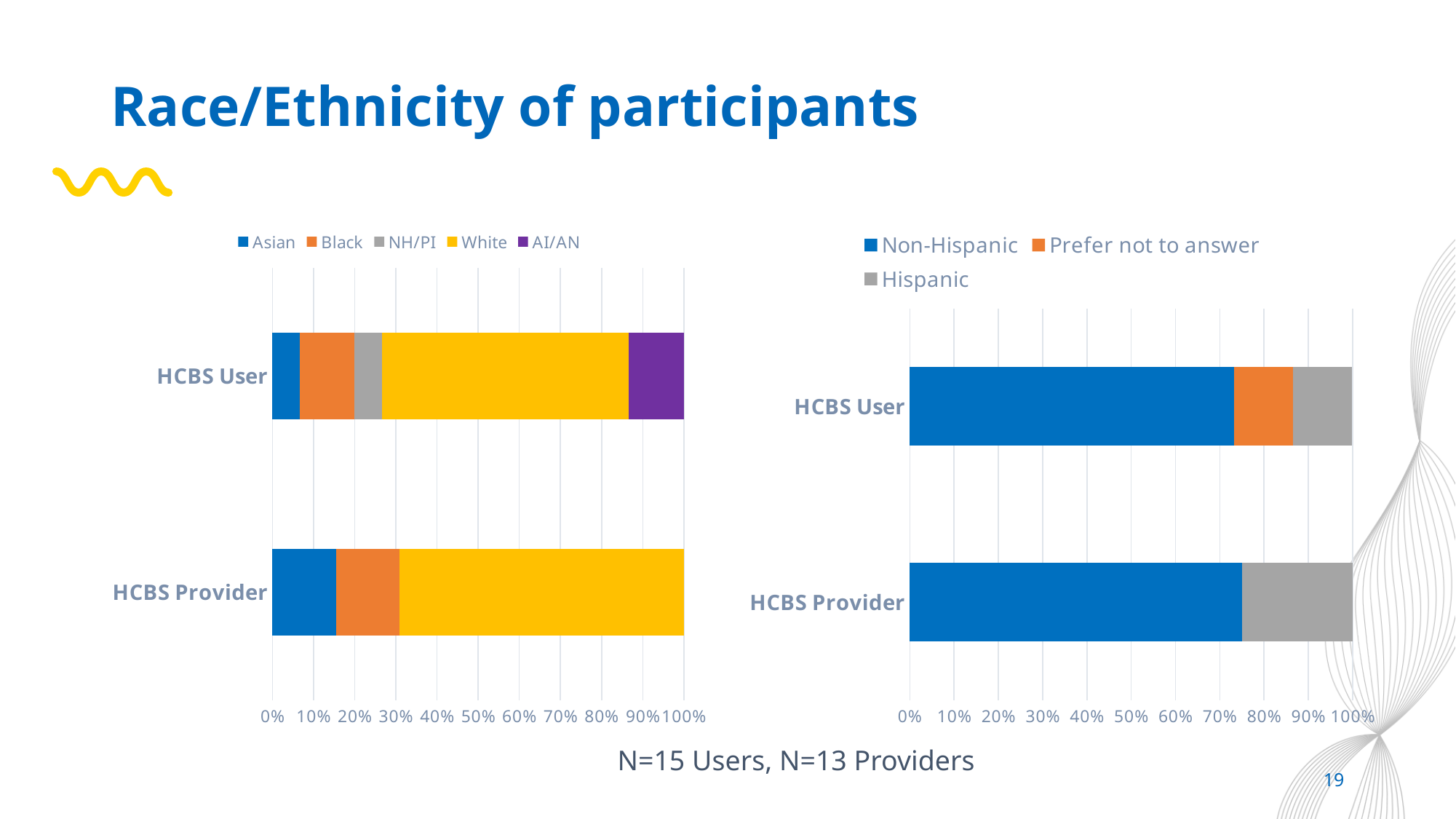
In the left chart, is the White segment larger for HCBS User or HCBS Provider? HCBS Provider How many series does the legend of the left chart list? 5 In the right chart, is the Hispanic share for HCBS Provider greater or less than 20%? greater What kind of chart is the left chart (race of participants)? Stacked bar chart In the left chart, is the Asian share for HCBS Provider greater or less than 20%? less What are the legend entries of the right chart? Non-Hispanic, Prefer not to answer, Hispanic In the left chart, which category includes an AI/AN segment? HCBS User In the left chart, is the White share for HCBS User greater or less than 50%? greater How many series does the legend of the right chart list? 3 In the left chart, which race group makes up the largest segment for HCBS Provider? White How many categories (bars) are shown in the left chart? 2